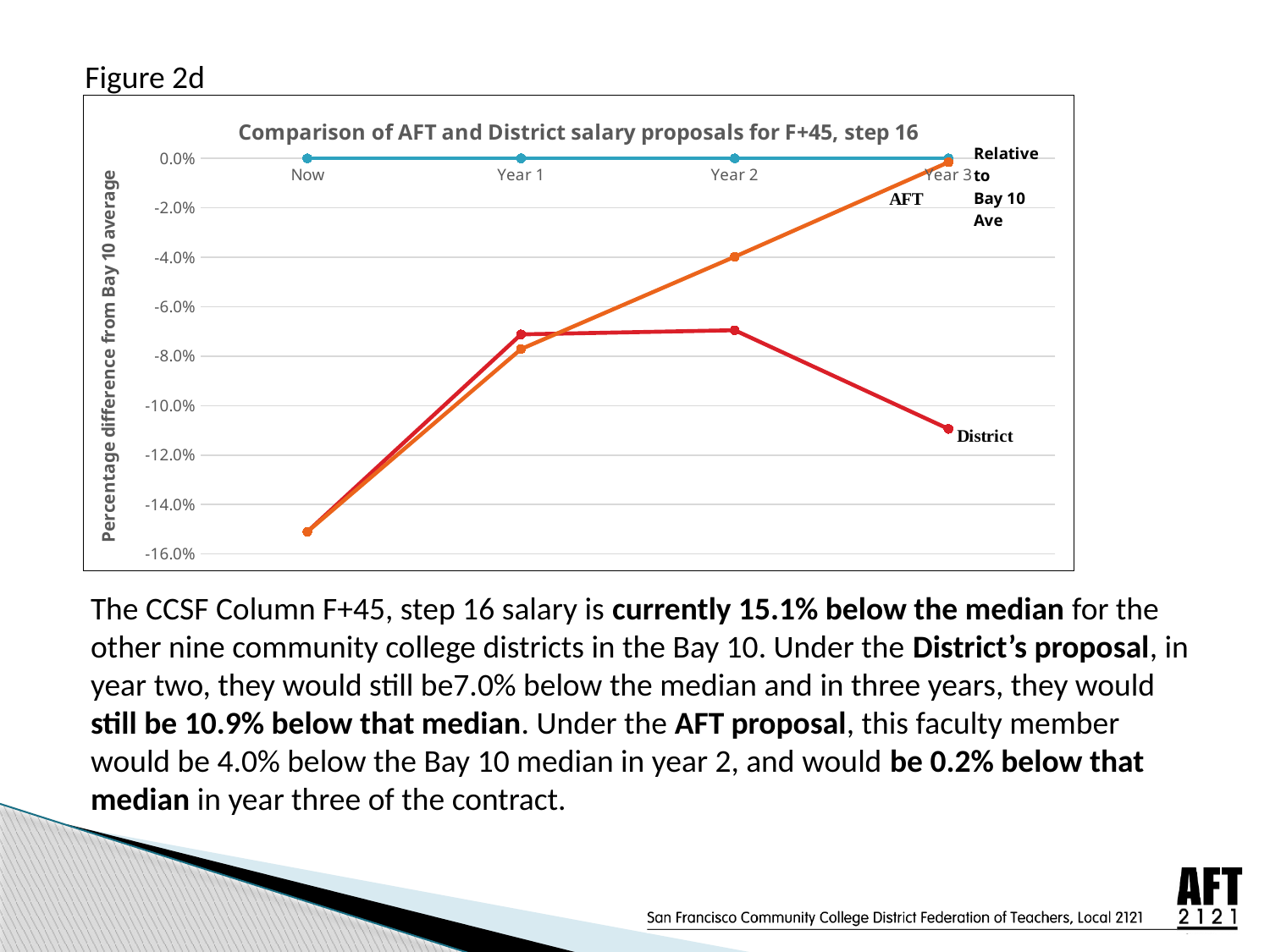
At which x-axis point is the District line at its lowest? Now At Year 3, which is higher: the AFT line or the District line? AFT What type of chart is shown on the slide? line chart What is the title of the chart? Comparison of AFT and District salary proposals for F+45, step 16 Is the value at 'Now' greater or less than -14.0%? less Does the AFT line rise or fall from Now to Year 3? rises What is the value of the AFT line at Year 2? -4.0% Is the value of the District line at Year 3 greater or less than -10.0%? less How many points are on the x axis of the chart? 4 Is the value of the AFT line at Year 1 greater or less than -6.0%? less What is the value of the 'Relative to Bay 10 Ave' line at Year 1? 0.0% How many series are plotted in the chart? 3